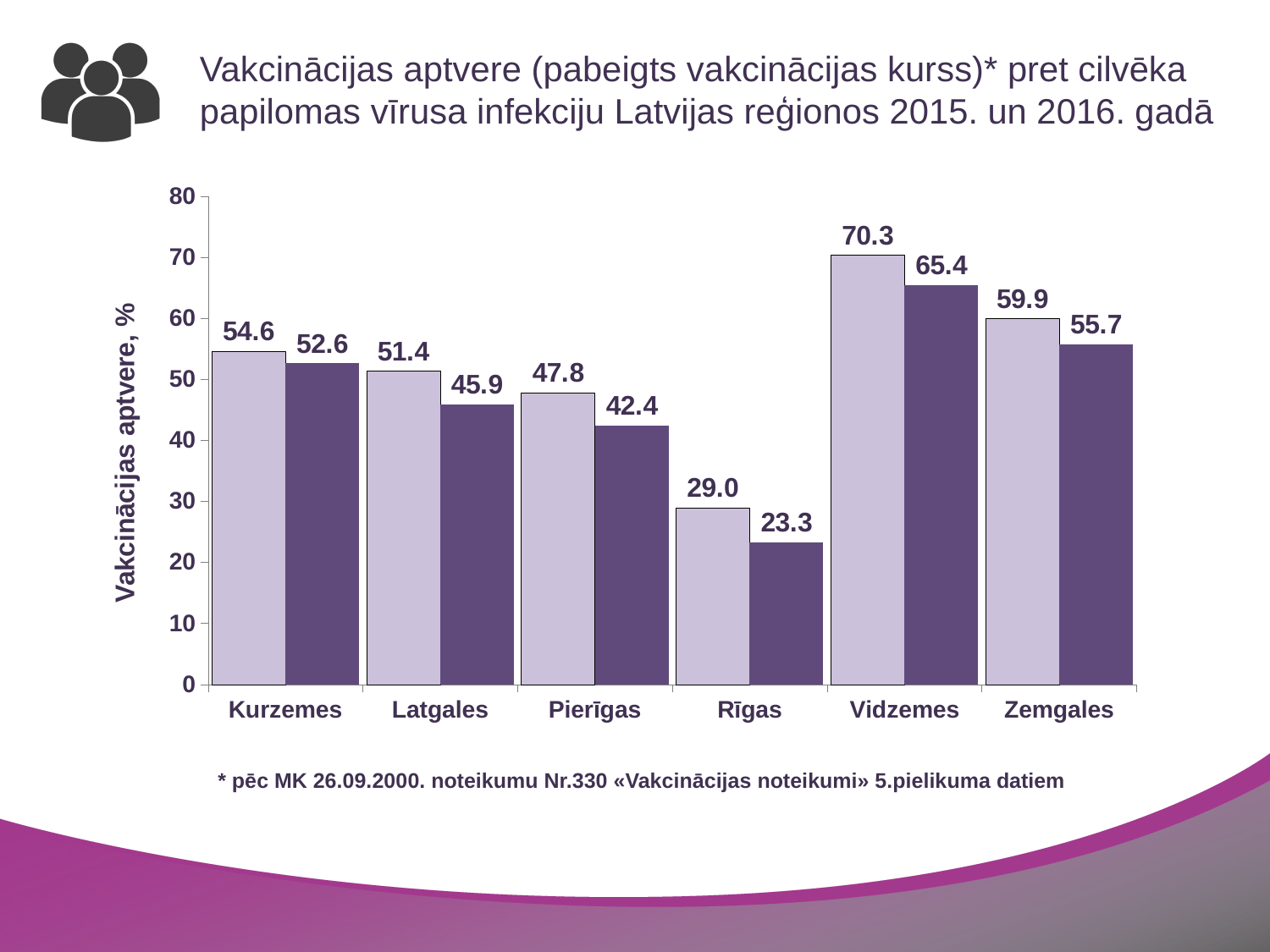
How many regions are shown on the x axis of the chart? 6 Which region has the highest value among the lighter bars? Vidzemes Is the darker bar for Vidzemes greater or less than 60? greater What is the value of the lighter bar for Vidzemes? 70.3 What is the difference between the lighter and darker bars for Latgales? 5.5 What type of chart is shown on the slide? bar chart What is the value of the lighter bar for Kurzemes? 54.6 What is the value of the darker bar for Rīgas? 23.3 Which region has the lowest value among the darker bars? Rīgas What is the label of the y axis? Vakcinācijas aptvere, % What is the value of the darker bar for Zemgales? 55.7 Which is larger for Pierīgas, the lighter bar or the darker bar? the lighter bar